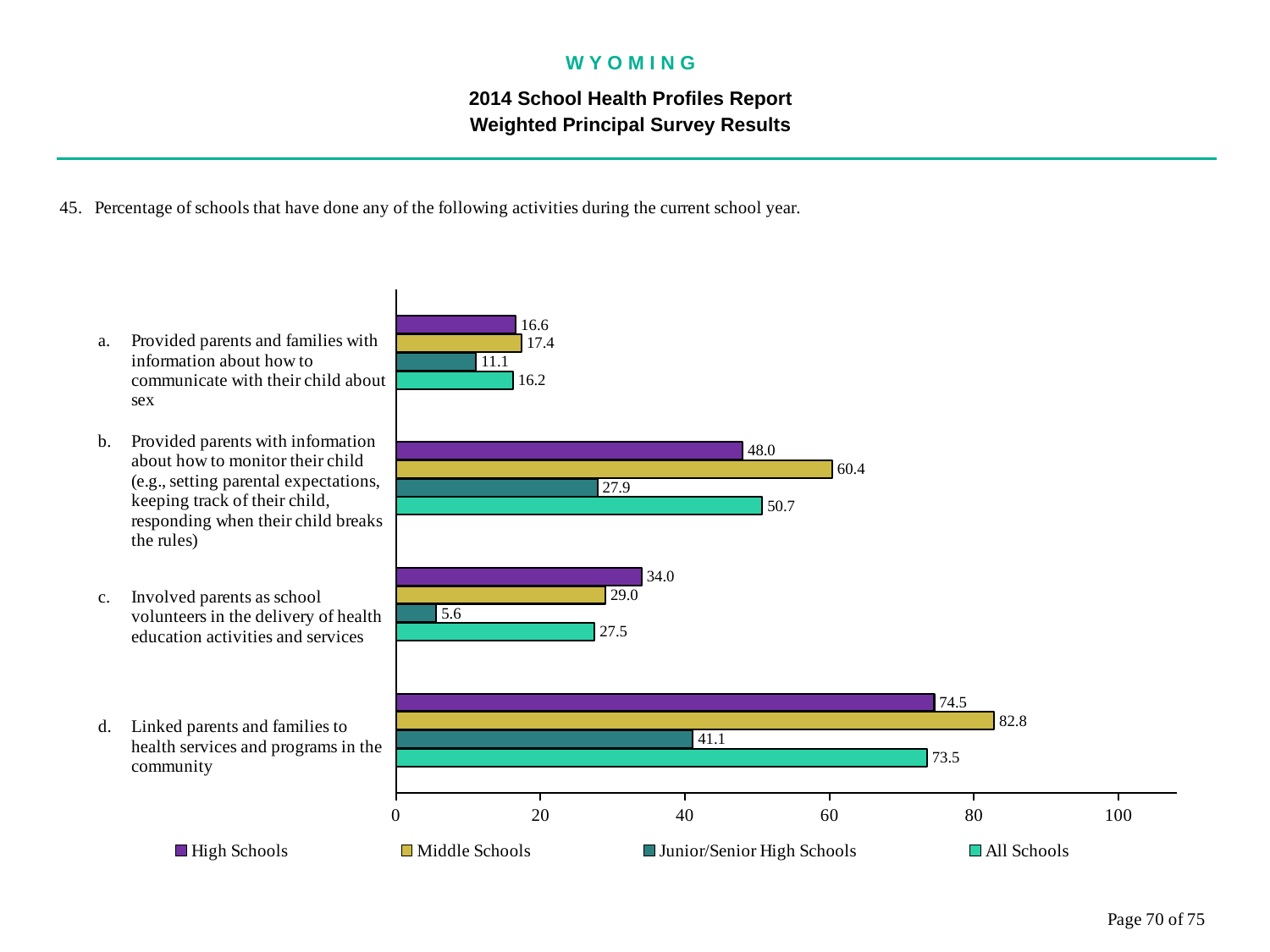
Is the All Schools value for activity d greater or less than 60? greater Which school type has the lowest value for activity c (Involved parents as school volunteers in the delivery of health education activities and services)? Junior/Senior High Schools What is the value for Middle Schools for activity d (Linked parents and families to health services and programs in the community)? 82.8 What is the difference between the Middle Schools and High Schools values for activity b? 12.4 What kind of chart is shown on the slide? Bar chart For activity c, which is larger: the High Schools value or the Middle Schools value? High Schools What is the value for All Schools for activity b (Provided parents with information about how to monitor their child)? 50.7 What is the value for Junior/Senior High Schools for activity a (Provided parents and families with information about how to communicate with their child about sex)? 11.1 How many activities (categories) are shown in the chart? 4 Which activity has the highest value for High Schools? d. Linked parents and families to health services and programs in the community How many series does the legend list? 4 Which legend entry is shown in purple? High Schools